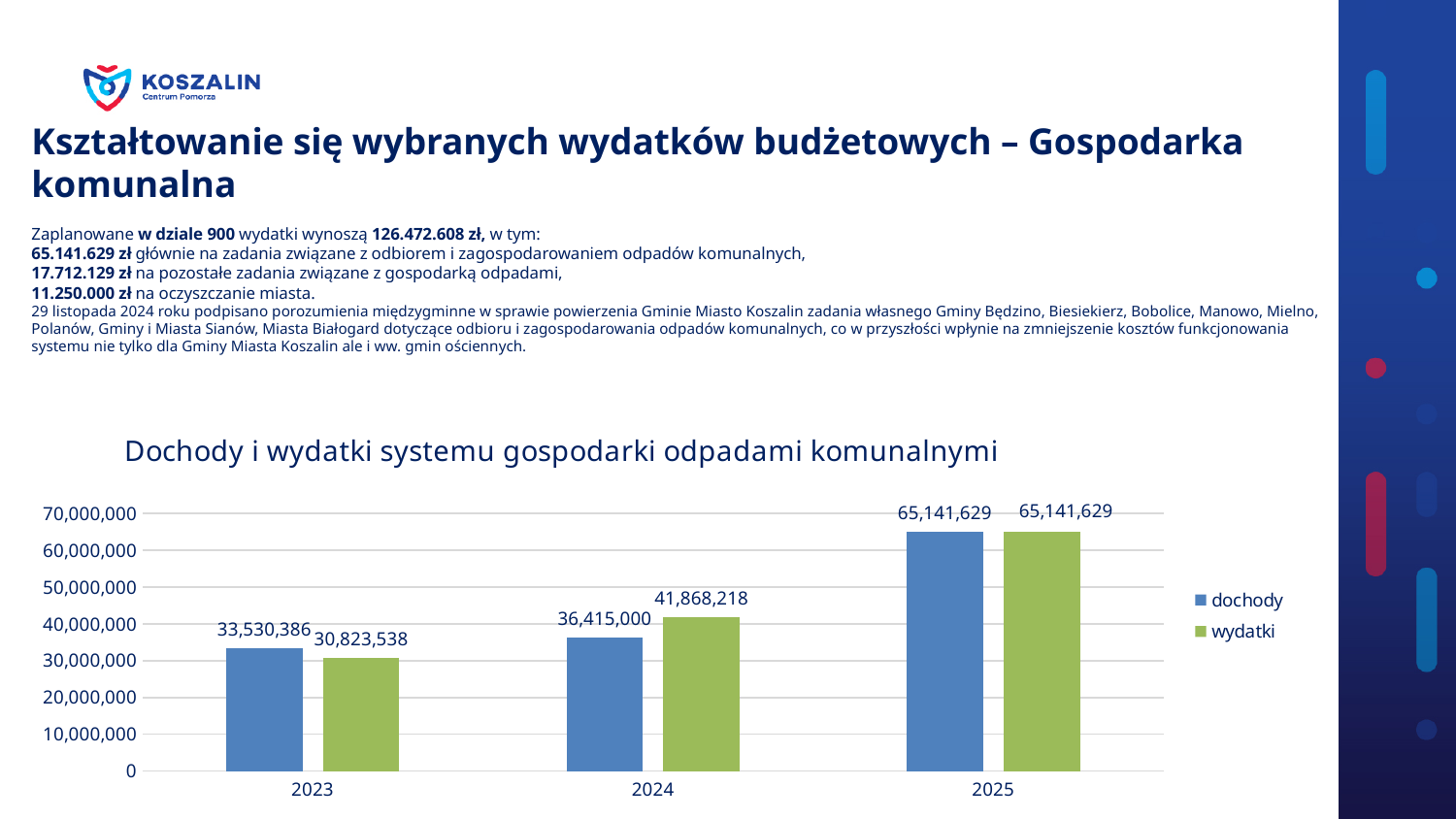
What is the difference between wydatki and dochody in 2024? 5,453,218 What is the difference between dochody and wydatki in 2023? 2,706,848 Is the value of wydatki for 2023 greater or less than 40,000,000? less What is the value of dochody for 2023? 33,530,386 Which year has the lowest dochody value? 2023 What is the value of dochody for 2025? 65,141,629 How many series does the legend list? 2 What is the value of wydatki for 2024? 41,868,218 How many years are shown on the x axis? 3 Which year has the highest wydatki value? 2025 In 2024, which is larger: dochody or wydatki? wydatki What kind of chart is shown on the slide? bar chart